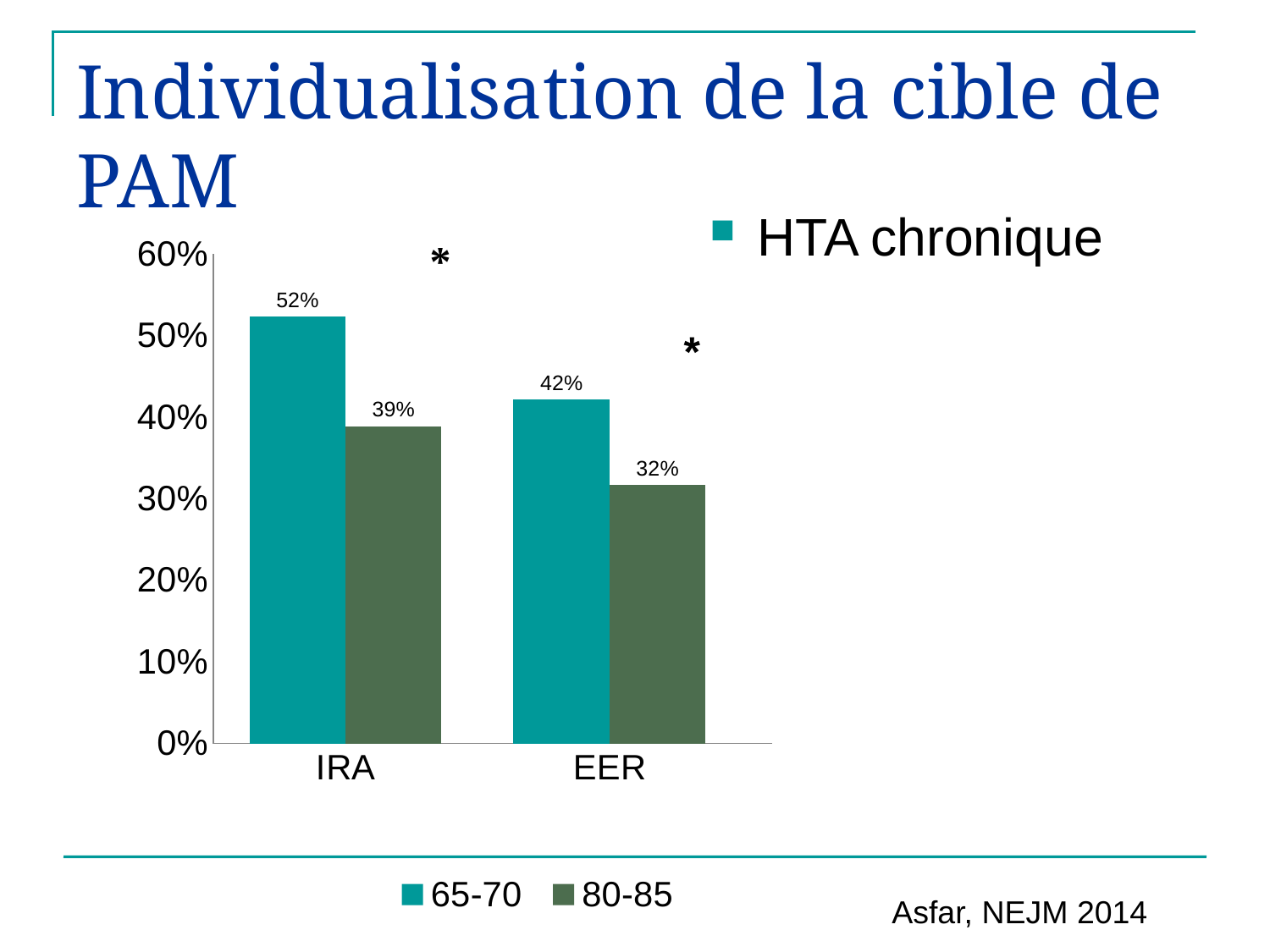
What is the value for IRA in the 80-85 series? 39% What is the value for EER in the 80-85 series? 32% What is the difference between the 65-70 and 80-85 values for IRA? 13% What is the value for EER in the 65-70 series? 42% How many categories are shown on the x axis? 2 Which category has the lowest value in the 80-85 series? EER Which category has the highest value in the 65-70 series? IRA What is the value for IRA in the 65-70 series? 52% What kind of chart is shown on the slide? Bar chart What is the difference between the 65-70 and 80-85 values for EER? 10% How many series does the legend list? 2 Which is larger: the 80-85 value for IRA or the 65-70 value for EER? 65-70 value for EER